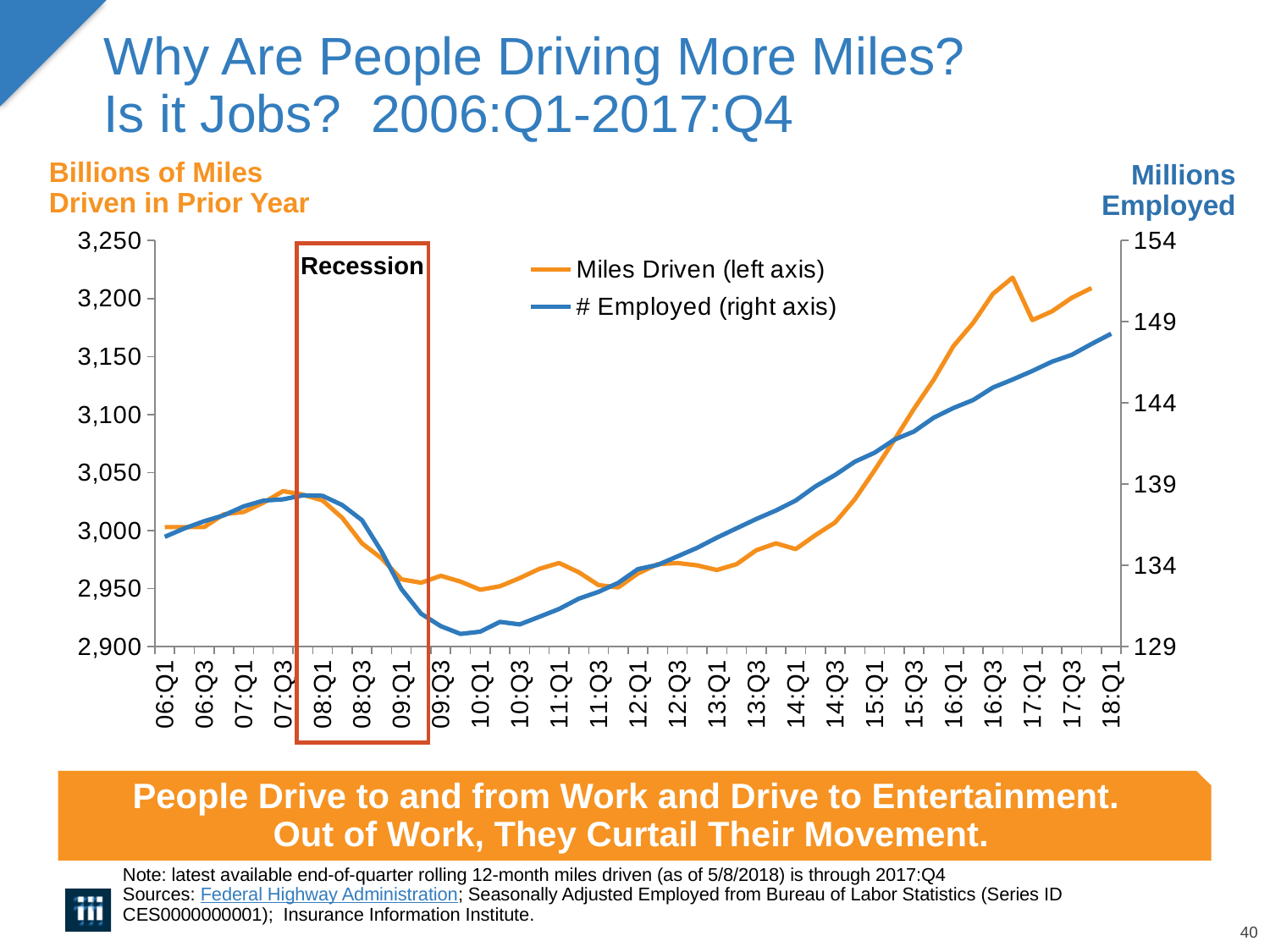
Is the value for # Employed at 18:Q1 greater or less than 144? greater Is the value for # Employed at 17:Q1 greater or less than 144? greater How many series does the legend list? 2 Is the value for # Employed at 10:Q1 greater or less than 134? less What period does the red box on the chart mark? Recession Does the Miles Driven series rise or fall between 15:Q1 and 16:Q3? rise Which series is plotted in orange? Miles Driven (left axis) Does the Miles Driven series rise or fall between 08:Q1 and 09:Q1? fall What kind of chart is shown on the slide? line chart Does the # Employed series rise or fall between 10:Q1 and 18:Q1? rise